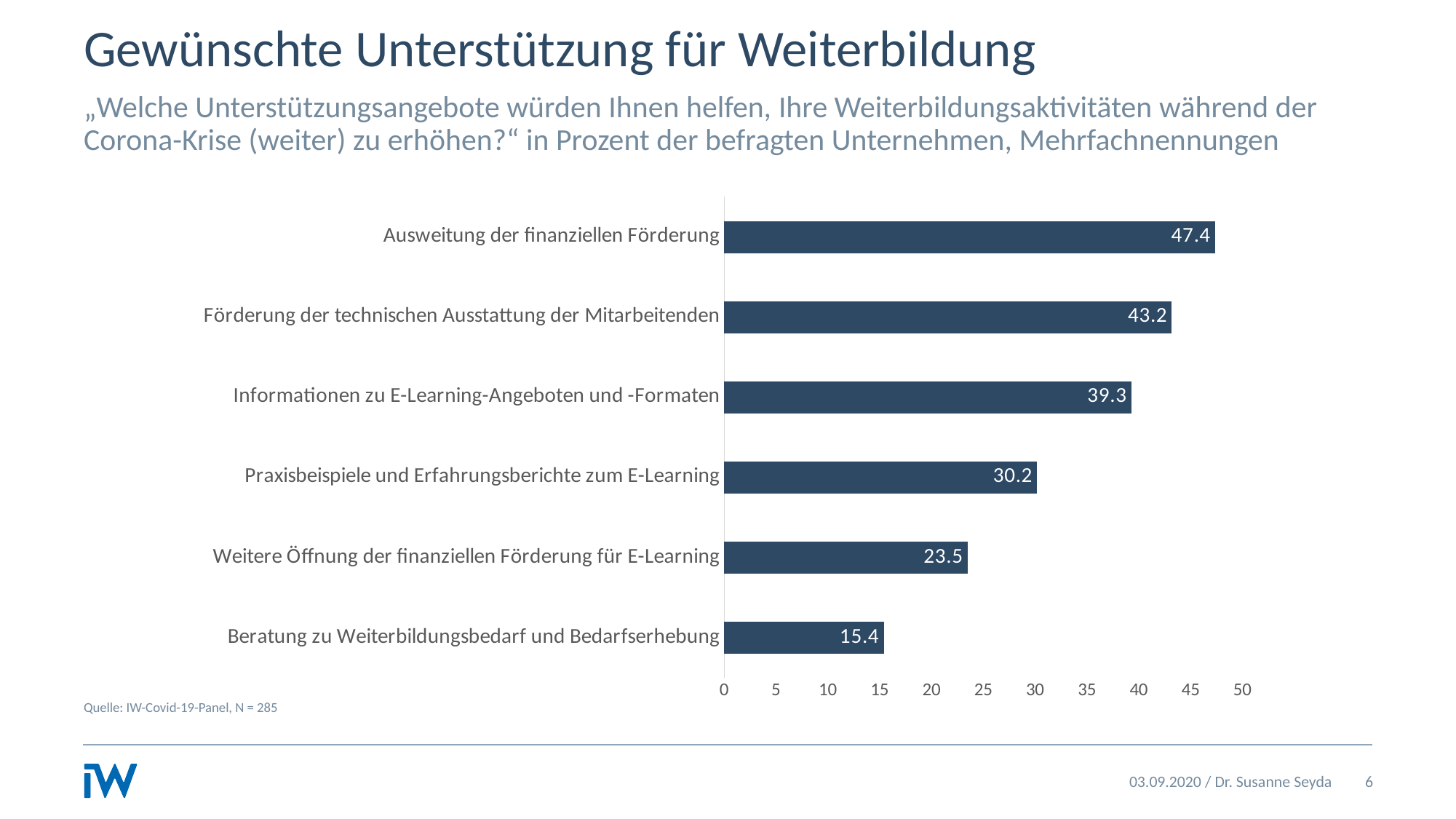
What is the difference between the values for "Ausweitung der finanziellen Förderung" and "Förderung der technischen Ausstattung der Mitarbeitenden"? 4.2 What is the difference between the values for "Praxisbeispiele und Erfahrungsberichte zum E-Learning" and "Weitere Öffnung der finanziellen Förderung für E-Learning"? 6.7 What is the value for "Informationen zu E-Learning-Angeboten und -Formaten"? 39.3 What kind of chart is shown on the slide? Bar chart Which category has the lowest value? Beratung zu Weiterbildungsbedarf und Bedarfserhebung Which is larger: the value for "Informationen zu E-Learning-Angeboten und -Formaten" or for "Praxisbeispiele und Erfahrungsberichte zum E-Learning"? Informationen zu E-Learning-Angeboten und -Formaten Which category has the highest value? Ausweitung der finanziellen Förderung What is the value for "Ausweitung der finanziellen Förderung"? 47.4 What is the value for "Beratung zu Weiterbildungsbedarf und Bedarfserhebung"? 15.4 What is the source given below the chart? IW-Covid-19-Panel, N = 285 Is the value for "Weitere Öffnung der finanziellen Förderung für E-Learning" greater or less than 25? less How many categories are shown in the chart? 6